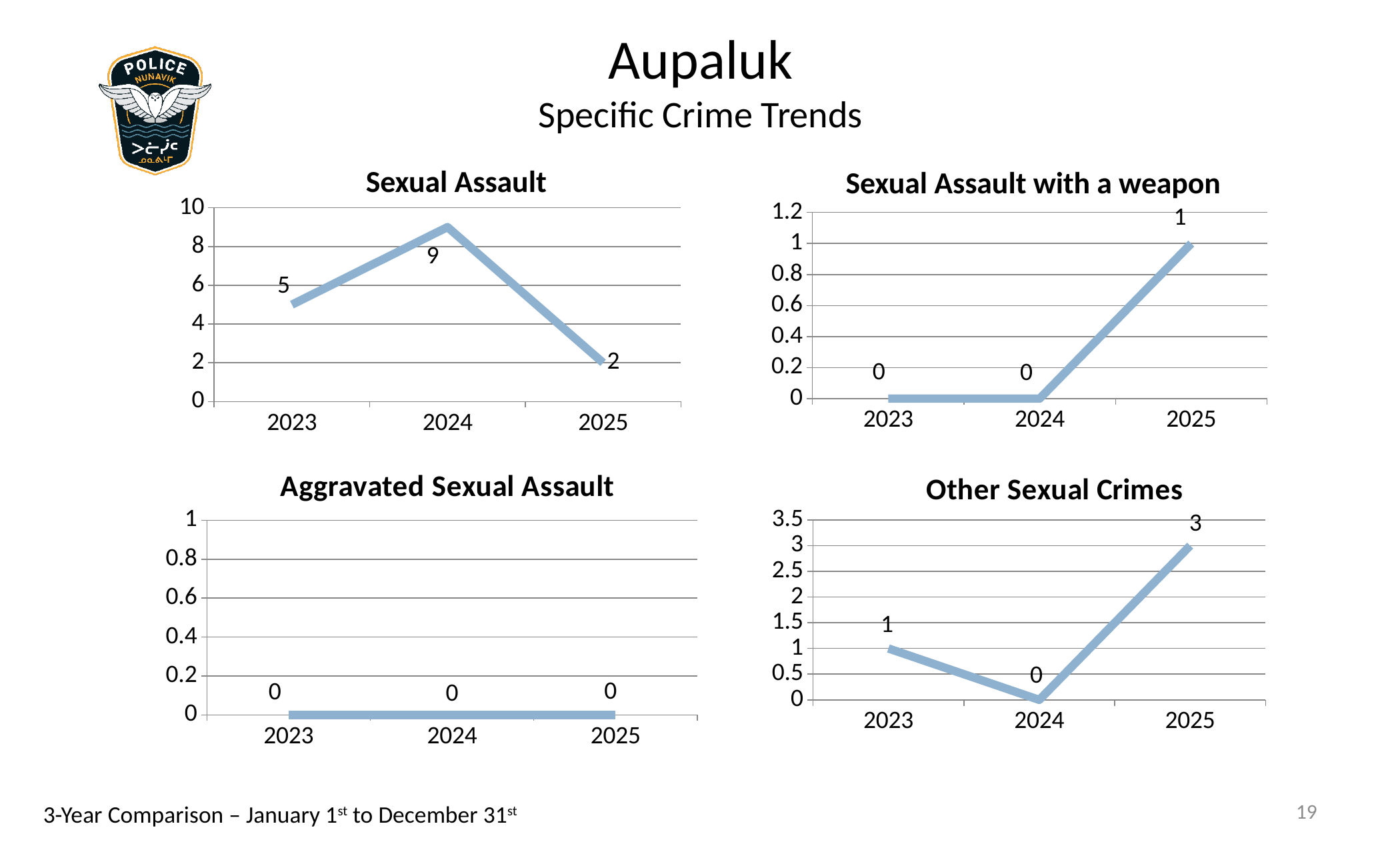
In the Other Sexual Crimes chart, which year has the highest value? 2025 In the Sexual Assault chart, what is the value for 2024? 9 In the Aggravated Sexual Assault chart, what is the value for 2024? 0 In the Other Sexual Crimes chart, what is the value for 2023? 1 What kind of chart is the Aggravated Sexual Assault chart? Line chart In the Sexual Assault with a weapon chart, how many years are plotted? 3 In the Other Sexual Crimes chart, is the value for 2025 larger than the value for 2023? Yes In the Sexual Assault with a weapon chart, what is the value for 2025? 1 In the Other Sexual Crimes chart, what is the difference between the 2025 and 2024 values? 3 What is the title of the chart in the top right of the slide? Sexual Assault with a weapon In the Sexual Assault chart, which year has the lowest value? 2025 In the Sexual Assault chart, what is the difference between the 2024 and 2023 values? 4